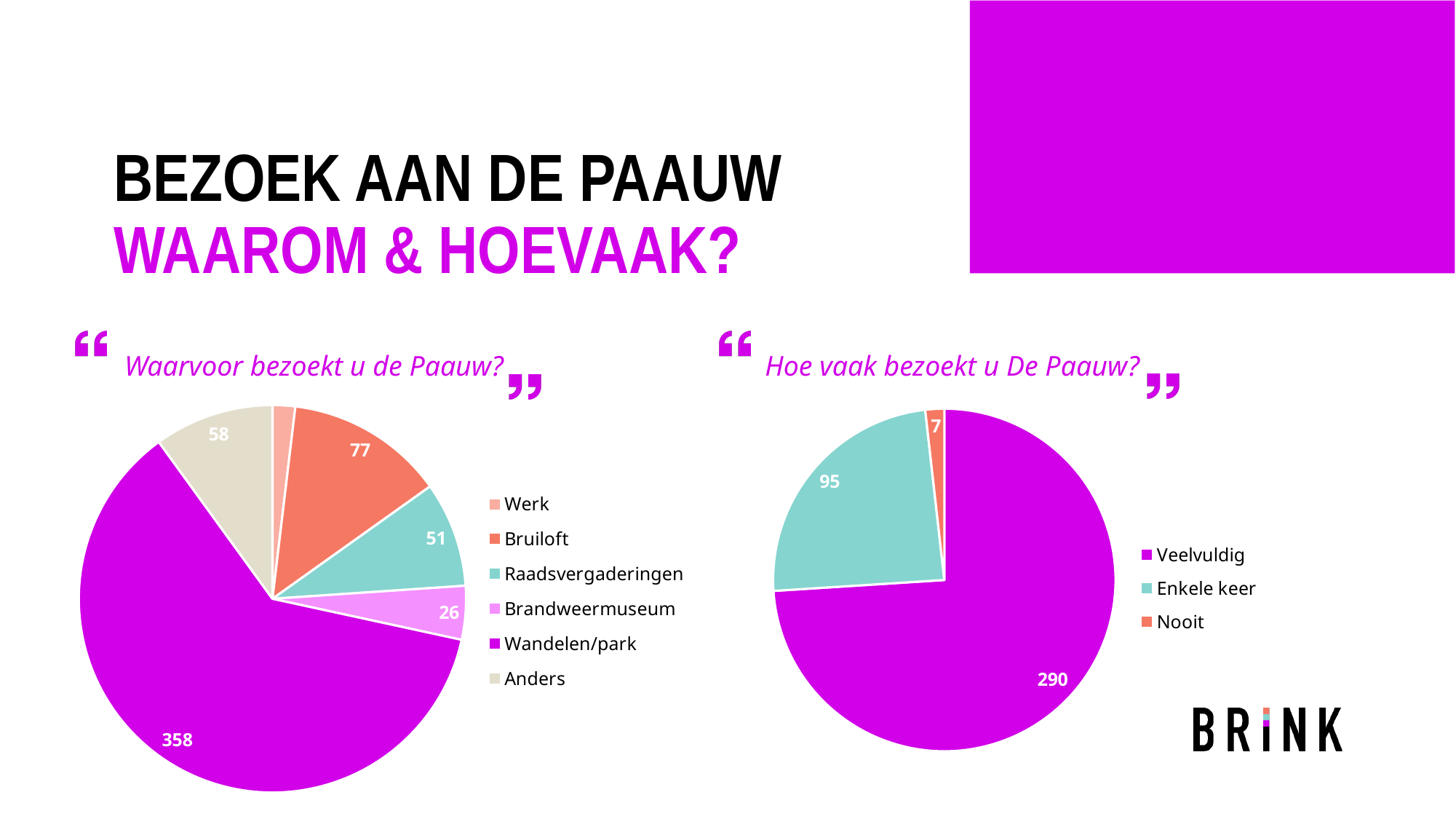
In the 'Waarvoor bezoekt u de Paauw?' chart, what is the difference between Bruiloft and Raadsvergaderingen? 26 In the 'Waarvoor bezoekt u de Paauw?' chart, which is larger: Anders or Brandweermuseum? Anders In the 'Hoe vaak bezoekt u De Paauw?' chart, what colour is the Veelvuldig slice? Magenta In the 'Hoe vaak bezoekt u De Paauw?' chart, what is the total of all slices? 392 How many categories does the legend of the 'Waarvoor bezoekt u de Paauw?' chart list? 6 In the 'Waarvoor bezoekt u de Paauw?' chart, what is the value for Wandelen/park? 358 In the 'Waarvoor bezoekt u de Paauw?' chart, what is the value for Bruiloft? 77 In the 'Waarvoor bezoekt u de Paauw?' chart, which category has the smallest slice? Werk In the 'Waarvoor bezoekt u de Paauw?' chart, which category has the largest slice? Wandelen/park In the 'Hoe vaak bezoekt u De Paauw?' chart, what is the value for Nooit? 7 In the 'Hoe vaak bezoekt u De Paauw?' chart, what is the value for Enkele keer? 95 What kind of chart is used for 'Waarvoor bezoekt u de Paauw?'? Pie chart